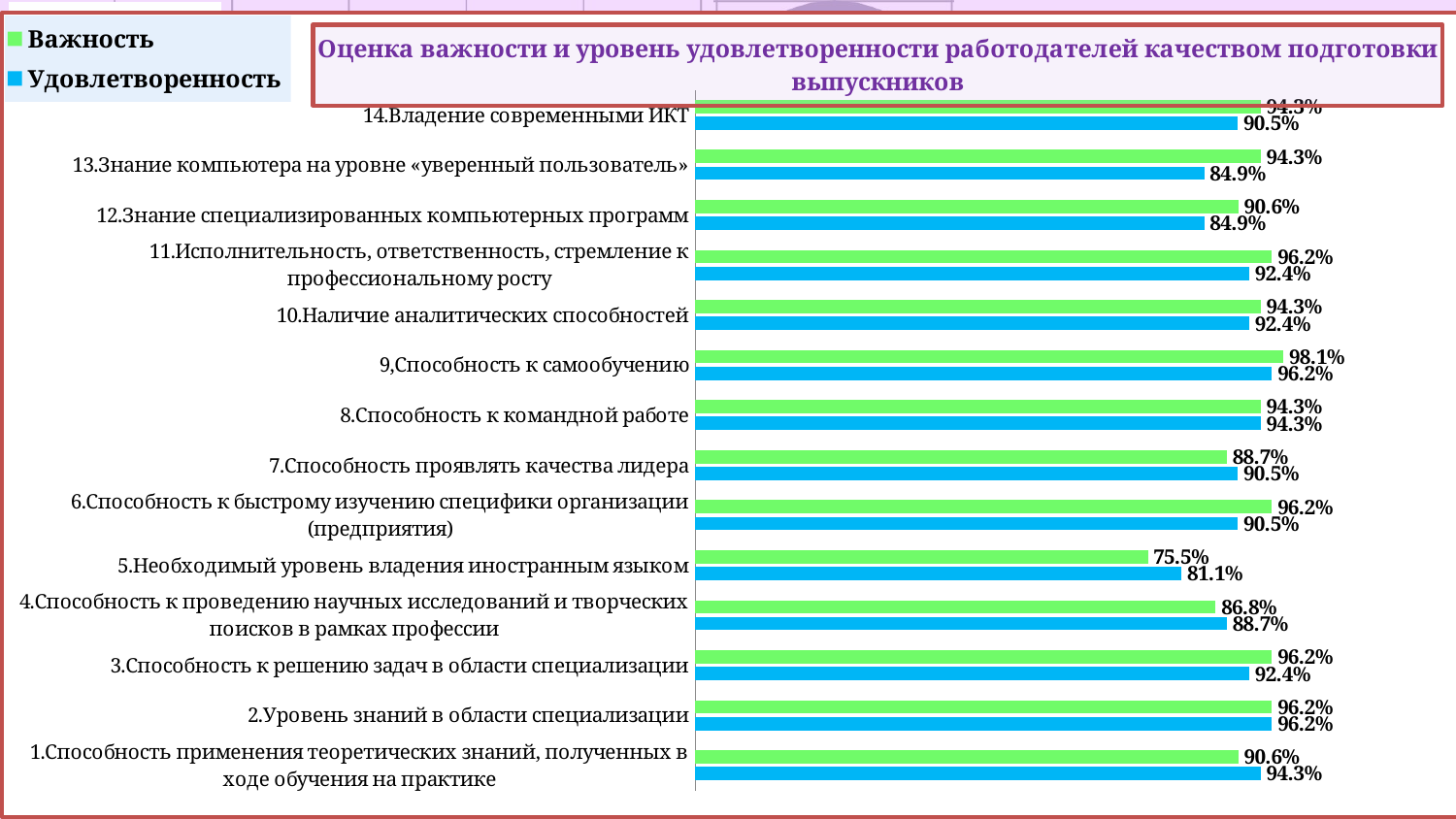
What is the difference between the Важность and Удовлетворенность values for "13.Знание компьютера на уровне «уверенный пользователь»"? 9.4% Which category has the lowest Важность value? 5.Необходимый уровень владения иностранным языком Which colour represents the Важность series in the chart? green What type of chart is shown on the slide? bar chart Which category has the highest Важность value? 9,Способность к самообучению What is the Удовлетворенность value for "13.Знание компьютера на уровне «уверенный пользователь»"? 84.9% What is the Важность value for "9,Способность к самообучению"? 98.1% Which category has the lowest Удовлетворенность value? 5.Необходимый уровень владения иностранным языком What is the Удовлетворенность value for "5.Необходимый уровень владения иностранным языком"? 81.1% For "7.Способность проявлять качества лидера", which is larger: Важность or Удовлетворенность? Удовлетворенность How many categories are plotted in the chart? 14 How many series does the legend list? 2